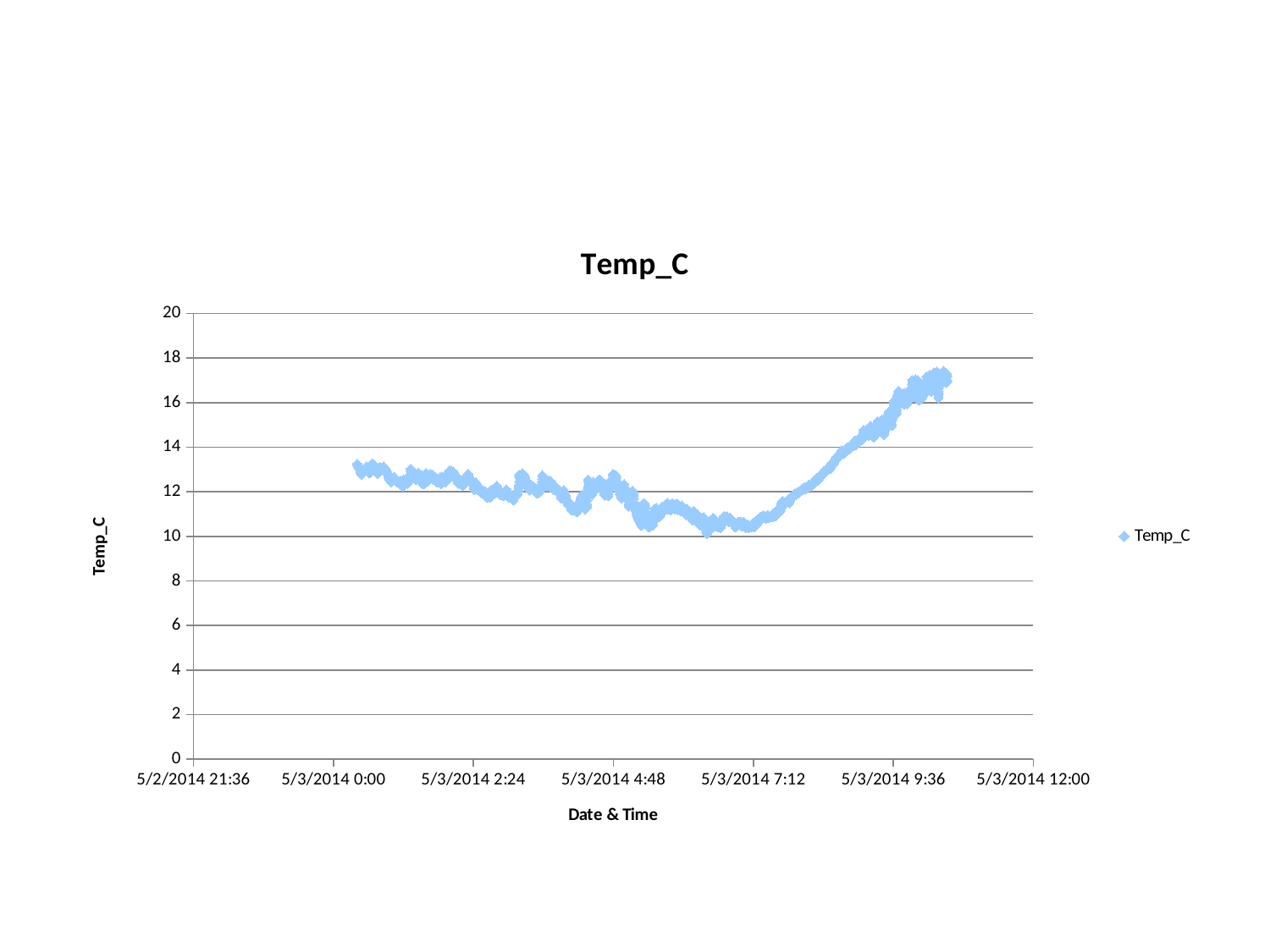
Is the value for Temp_C at 5/3/2014 7:12 greater or less than 14? less What is the label of the vertical axis? Temp_C Is the Temp_C value at 5/3/2014 9:36 larger or smaller than the value at 5/3/2014 7:12? larger Is the value for Temp_C at 5/3/2014 9:36 greater or less than 14? greater Is the value for Temp_C at 5/3/2014 7:12 greater or less than 12? less How many series does the legend list? 1 What is the highest value shown on the vertical axis? 20 Do the Temp_C values rise or fall between 5/3/2014 7:12 and the end of the series? rise What is the title of the chart? Temp_C What kind of chart is shown on the slide? scatter chart